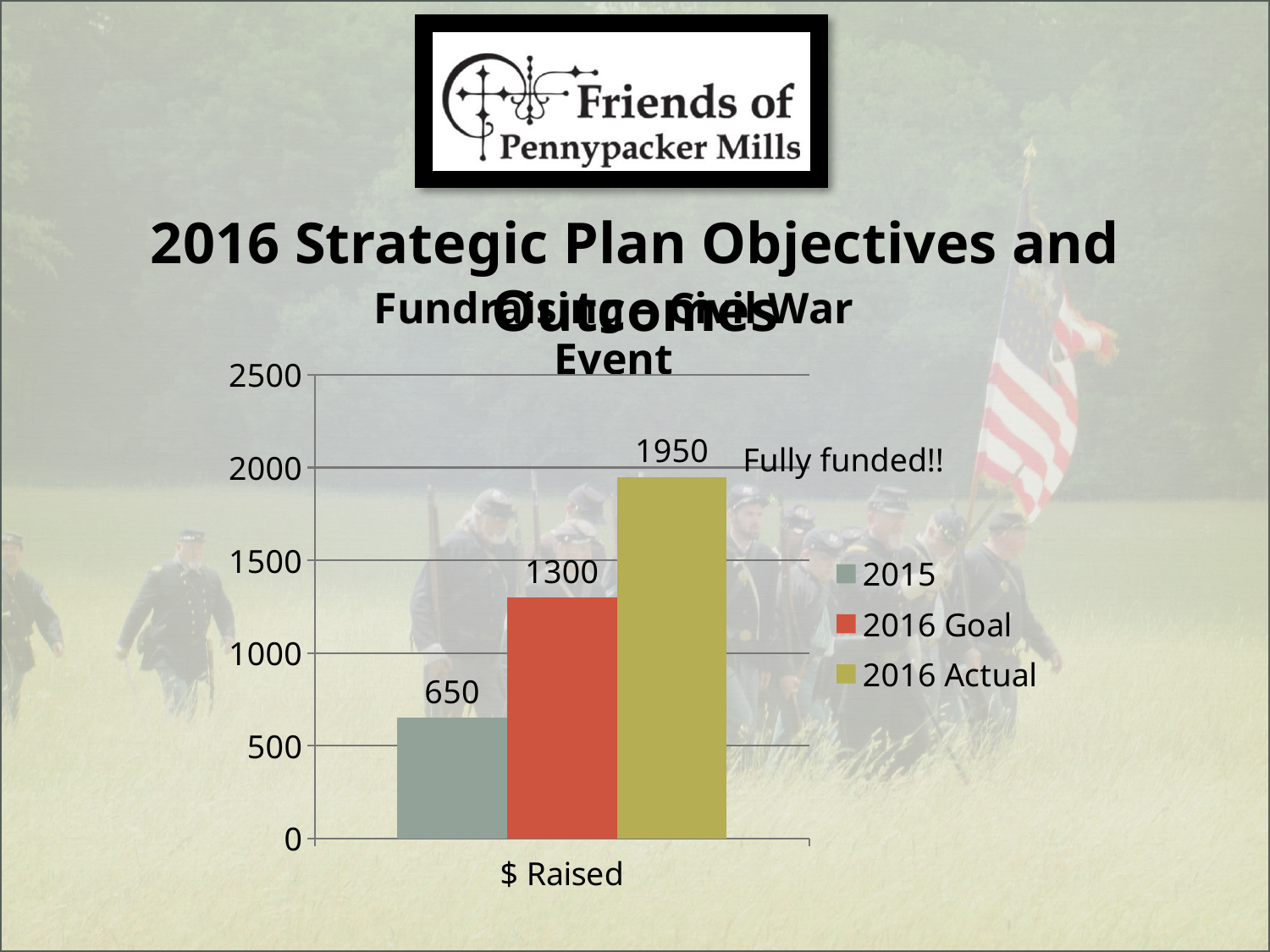
What kind of chart is shown on the slide? bar chart What is the value for the 2016 Goal series? 1300 Which series has the lowest value for $ Raised? 2015 What is the label of the category on the x axis? $ Raised What is the difference between the 2016 Goal and 2015 values? 650 What is the difference between the 2016 Actual and 2016 Goal values? 650 How many series does the legend list? 3 Is the value for 2016 Actual greater or less than 1500? greater What is the value for the 2015 series in the $ Raised category? 650 Which series has the highest value for $ Raised? 2016 Actual What is the value for the 2016 Actual series? 1950 Which is larger, the 2016 Goal value or the 2015 value? 2016 Goal